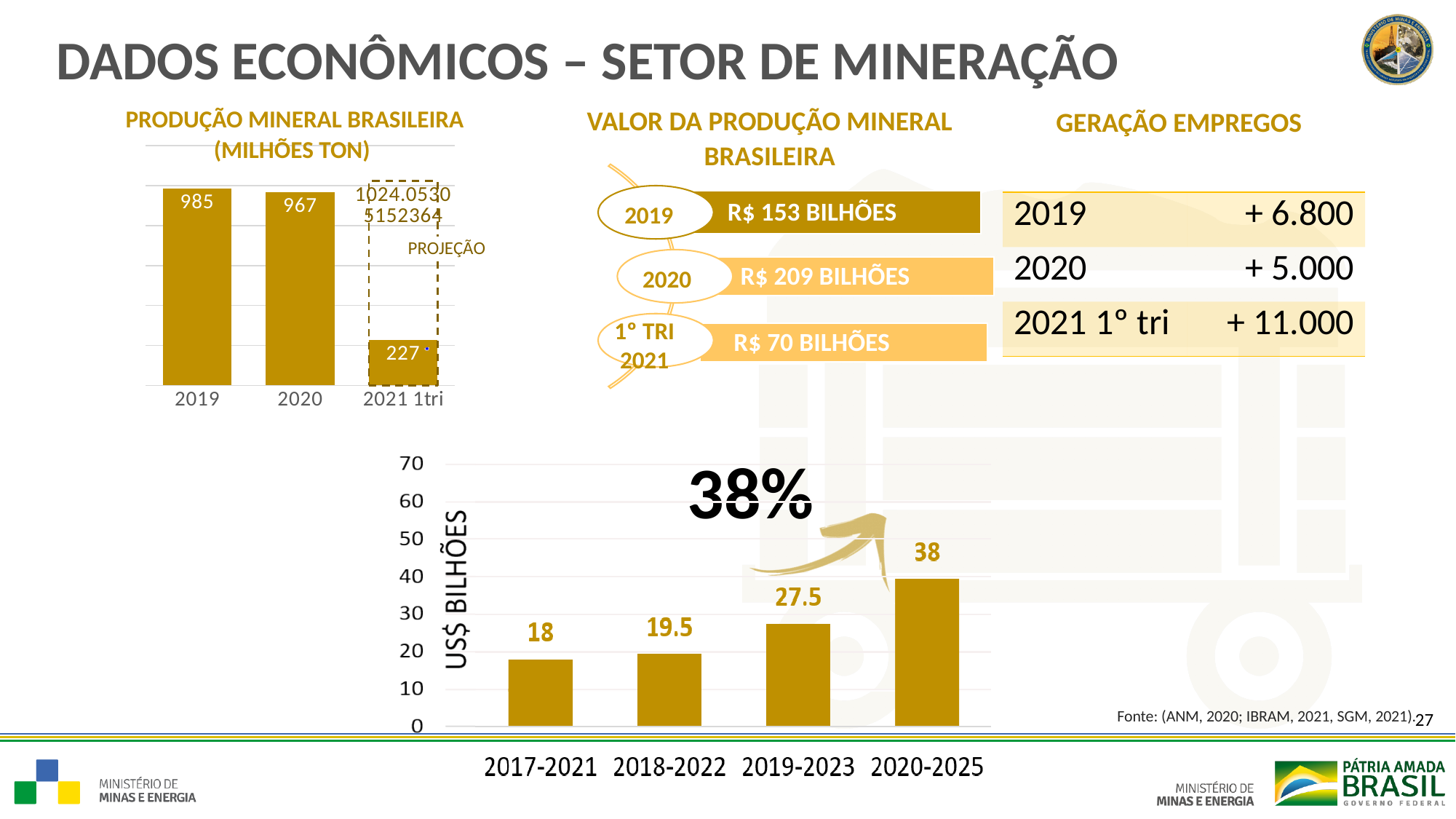
In the bottom chart with the US$ BILHÕES axis, do the values rise or fall from 2017-2021 to 2020-2025? Rise In the 'PRODUÇÃO MINERAL BRASILEIRA (MILHÕES TON)' chart, what kind of chart is shown? Bar chart In the 'PRODUÇÃO MINERAL BRASILEIRA (MILHÕES TON)' chart, what is the value for 2020? 967 In the 'PRODUÇÃO MINERAL BRASILEIRA (MILHÕES TON)' chart, which is larger, the value for 2019 or for 2020? 2019 In the bottom chart with the US$ BILHÕES axis, which period has the highest value? 2020-2025 In the 'PRODUÇÃO MINERAL BRASILEIRA (MILHÕES TON)' chart, what is the difference between the 2019 and 2020 values? 18 In the 'PRODUÇÃO MINERAL BRASILEIRA (MILHÕES TON)' chart, what is the value for 2021 1tri? 227 In the bottom chart with the US$ BILHÕES axis, what is the difference between the 2020-2025 and 2018-2022 values? 18.5 In the bottom chart with the US$ BILHÕES axis, what is the value for 2019-2023? 27.5 In the bottom chart with the US$ BILHÕES axis, which period has the lowest value? 2017-2021 In the bottom chart with the US$ BILHÕES axis, what is the value for 2017-2021? 18 In the 'PRODUÇÃO MINERAL BRASILEIRA (MILHÕES TON)' chart, what is the value for 2019? 985